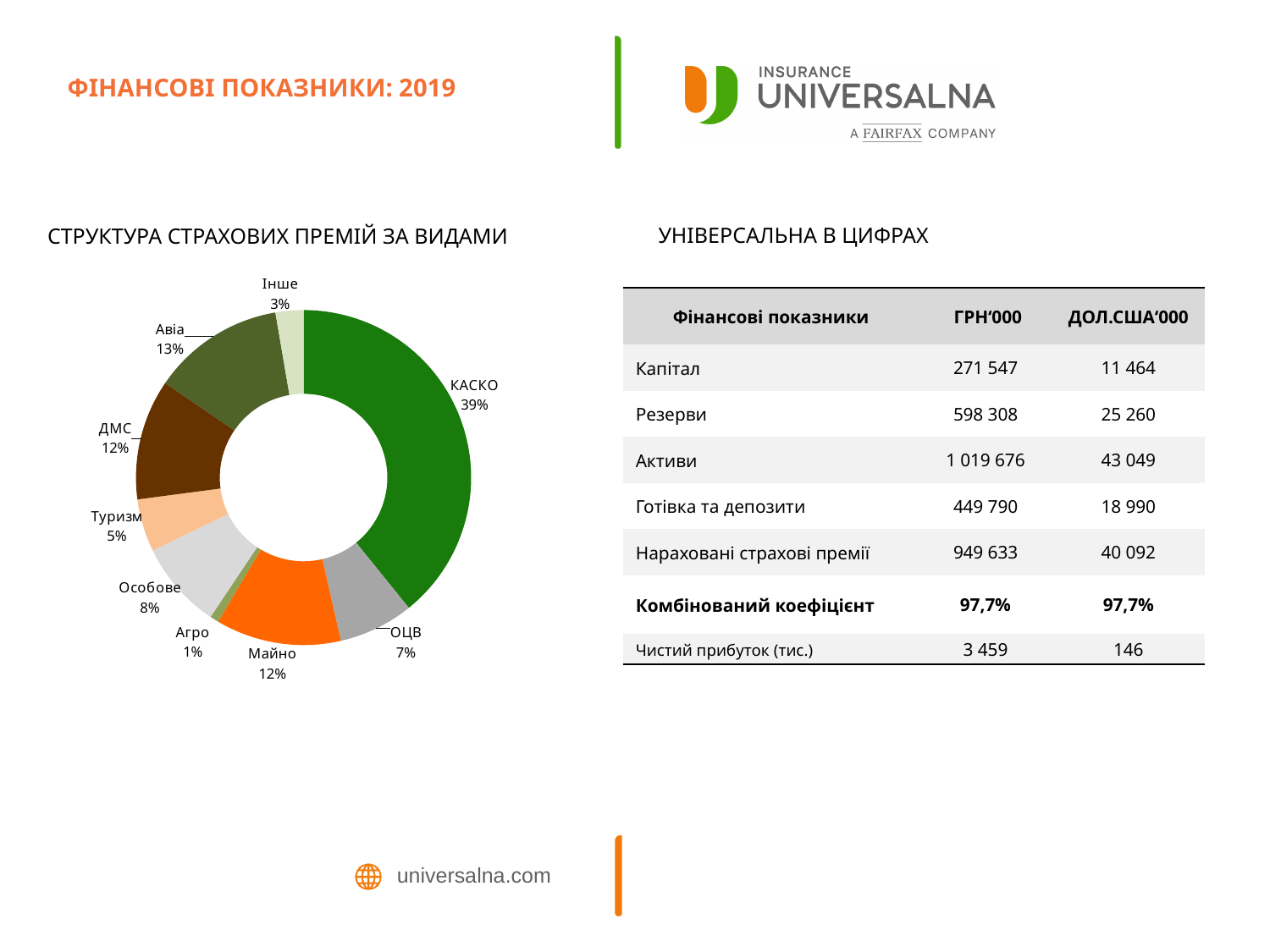
What kind of chart is used to show the structure of insurance premiums by type? Donut (pie) chart What percentage is shown for Туризм in the chart? 5% What is the share shown for Авіа in the chart? 13% What is the combined share of ДМС and Майно in the chart? 24% Which category has the largest share in the premium structure chart? КАСКО What share is shown for the Інше category in the chart? 3% What share of insurance premiums does КАСКО account for in the donut chart? 39% What is the title of the chart on the left of the slide? СТРУКТУРА СТРАХОВИХ ПРЕМІЙ ЗА ВИДАМИ How many categories are shown in the donut chart? 9 Which category has the smallest share in the premium structure chart? Агро What is the difference in percentage points between the shares of КАСКО and Авіа? 26 Which has a larger share in the chart, Особове or ОЦВ? Особове